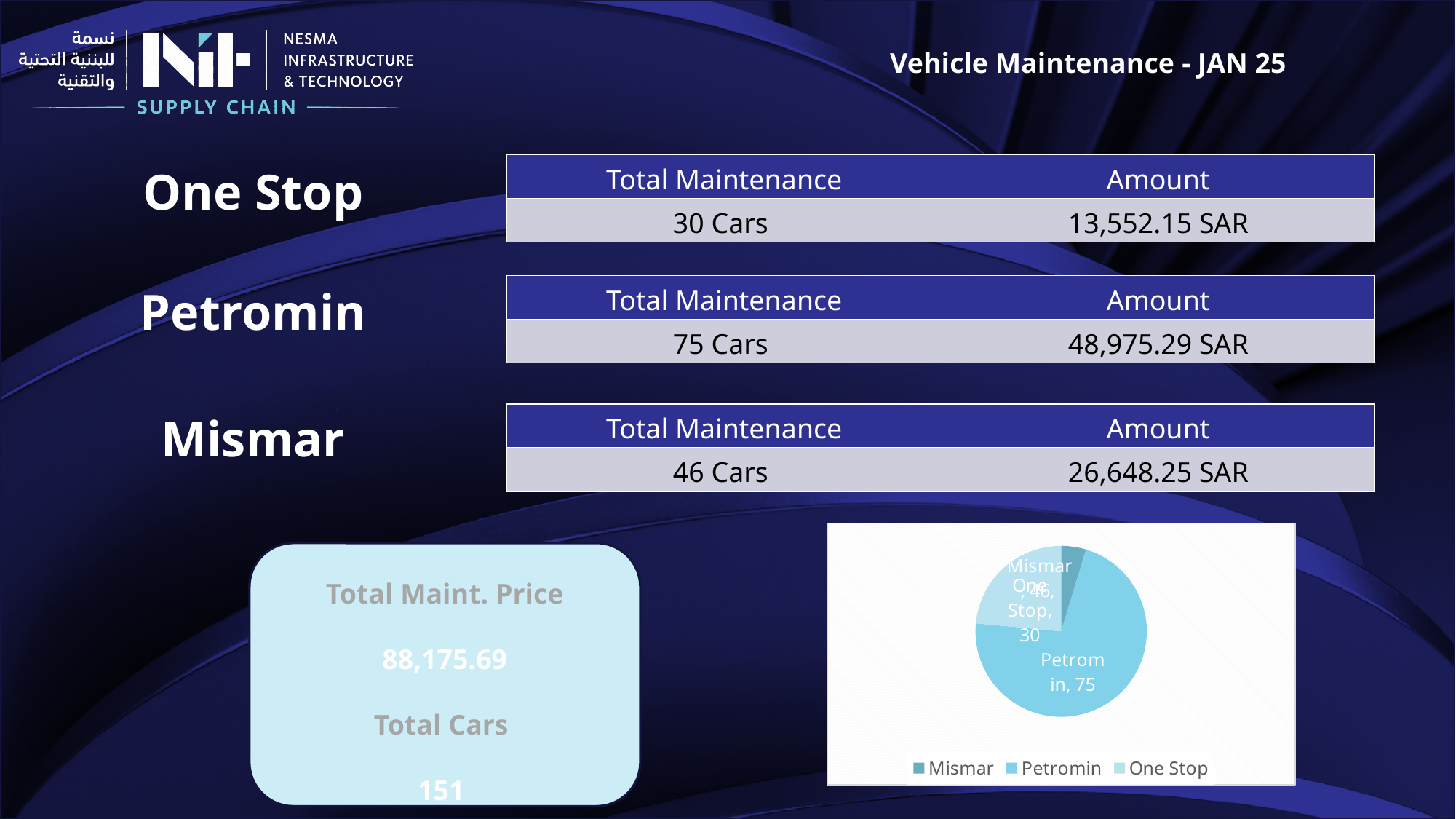
What value is shown for Mismar in the pie chart? 46 What value is shown for One Stop in the pie chart? 30 What is the total of all the values in the pie chart? 151 Which category has the smallest slice in the pie chart? Mismar How many slices does the pie chart have? 3 Which category has the largest slice in the pie chart? Petromin How many entries does the pie chart's legend list? 3 What kind of chart is shown on the slide? pie chart What value is shown for Petromin in the pie chart? 75 Which legend entry is listed first in the pie chart's legend? Mismar What is the difference between the Petromin and Mismar values in the pie chart? 29